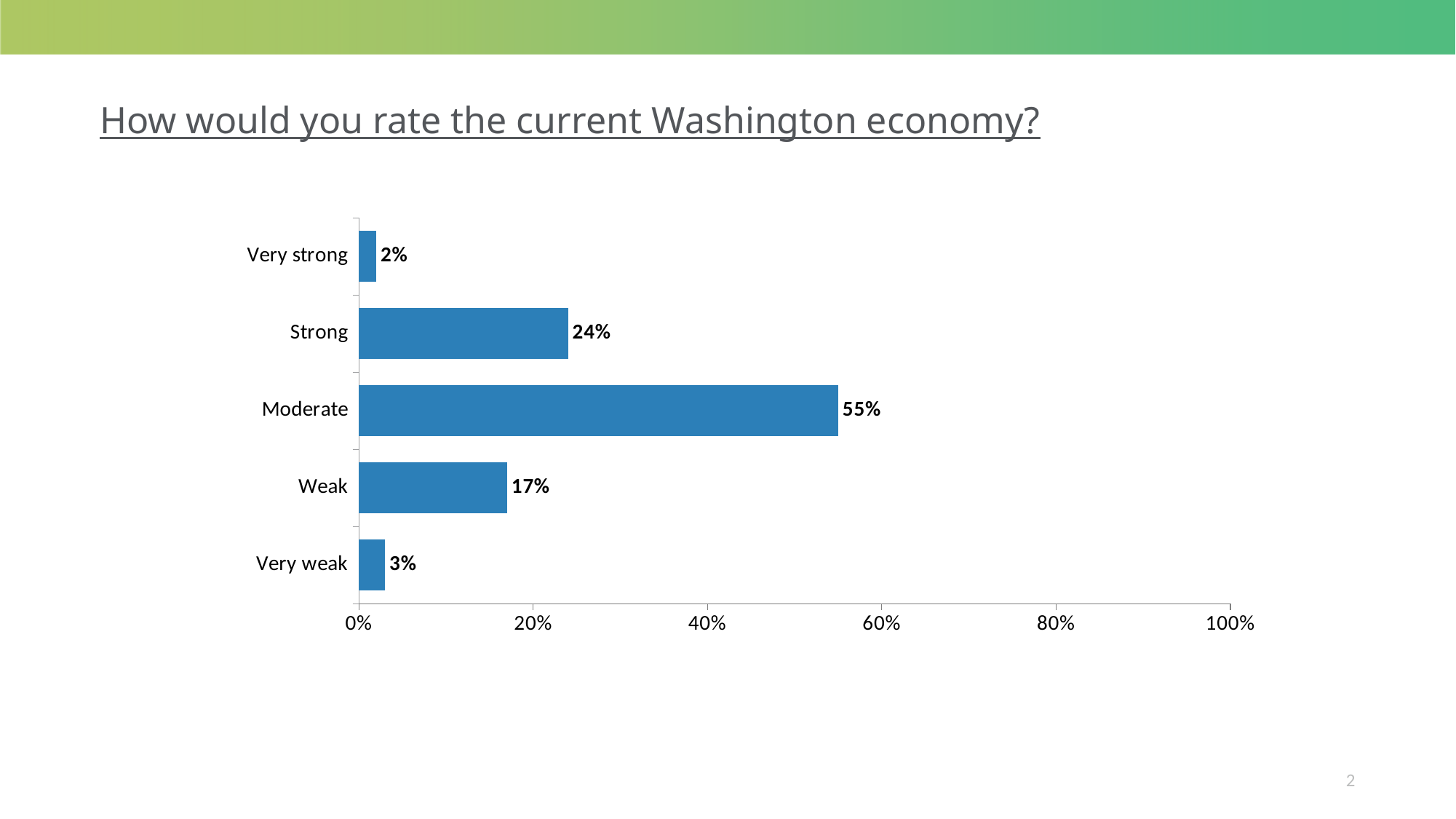
What percentage of respondents rated the Washington economy as Very weak? 3% What is the title of the slide? How would you rate the current Washington economy? What is the difference in percentage points between the Strong and Weak ratings? 7 Which has a larger percentage, Weak or Strong? Strong What percentage of respondents rated the Washington economy as Moderate? 55% What percentage of respondents rated the Washington economy as Strong? 24% How many rating categories are shown in the chart? 5 Which rating category has the lowest percentage? Very strong Which rating category has the highest percentage? Moderate Is the value for Moderate greater or less than 40%? greater What kind of chart is shown on the slide? Bar chart What is the difference in percentage points between the Moderate and Strong ratings? 31